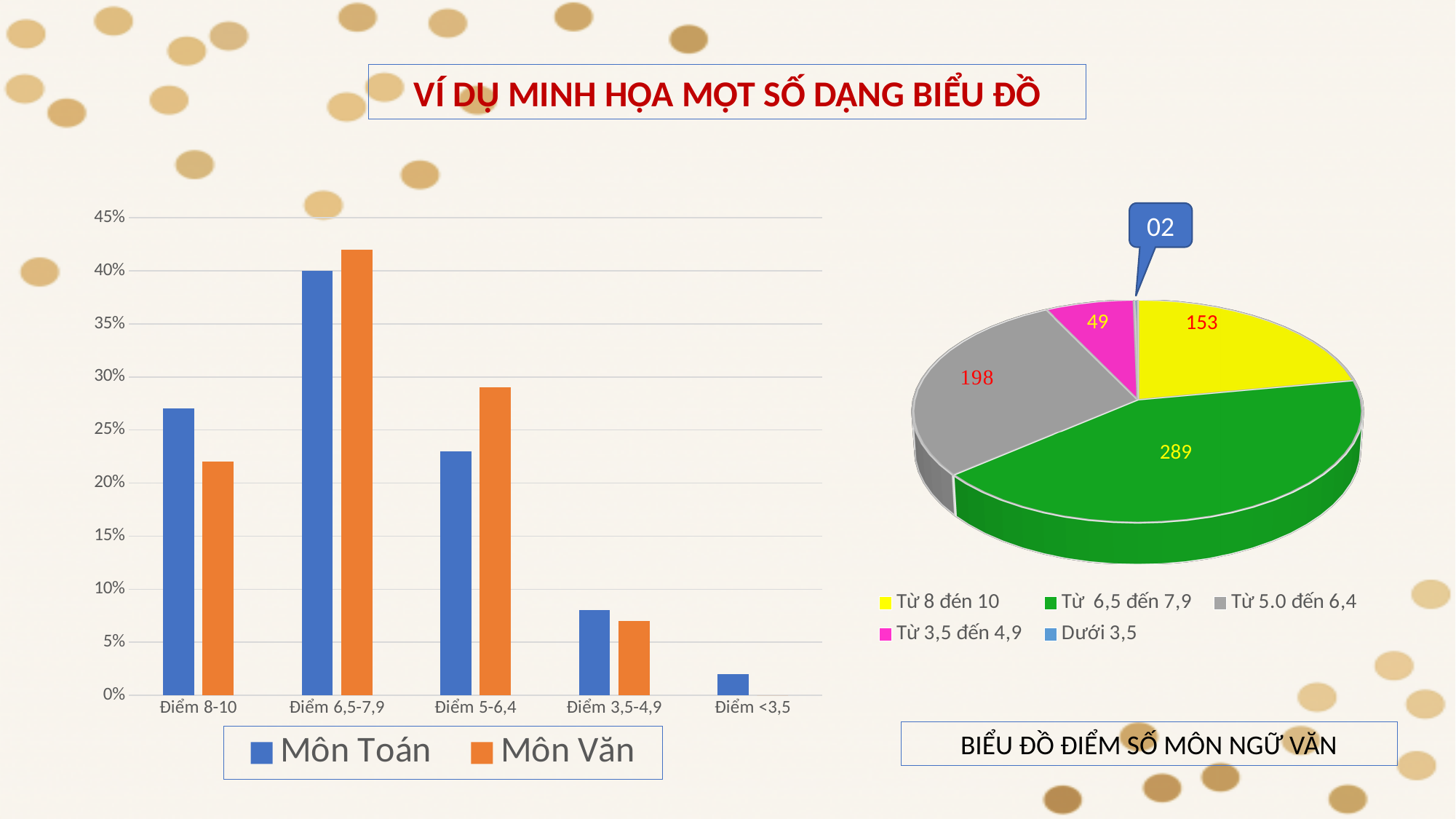
In the bar chart on the left, is the value for Môn Văn at Điểm 8-10 greater or less than 25%? less In the pie chart BIỂU ĐỒ ĐIỂM SỐ MÔN NGỮ VĂN, which category has the largest value? Từ 6,5 đến 7,9 In the pie chart BIỂU ĐỒ ĐIỂM SỐ MÔN NGỮ VĂN, what is the value for Từ 5.0 đến 6,4? 198 In the bar chart on the left, what is the value for Môn Toán at Điểm 6,5-7,9? 40% In the bar chart on the left, at Điểm 5-6,4, which series has the larger value, Môn Toán or Môn Văn? Môn Văn What kind of chart is the chart on the left side of the slide? bar chart What kind of chart is the chart titled BIỂU ĐỒ ĐIỂM SỐ MÔN NGỮ VĂN? pie chart In the bar chart on the left, how many series does the legend list? 2 In the pie chart BIỂU ĐỒ ĐIỂM SỐ MÔN NGỮ VĂN, what is the difference between the values for Từ 6,5 đến 7,9 and Từ 8 đến 10? 136 In the bar chart on the left, is the value for Môn Toán at Điểm 8-10 greater or less than 25%? greater In the bar chart on the left, how many categories are shown on the x axis? 5 In the pie chart BIỂU ĐỒ ĐIỂM SỐ MÔN NGỮ VĂN, which category has the smallest value? Dưới 3,5